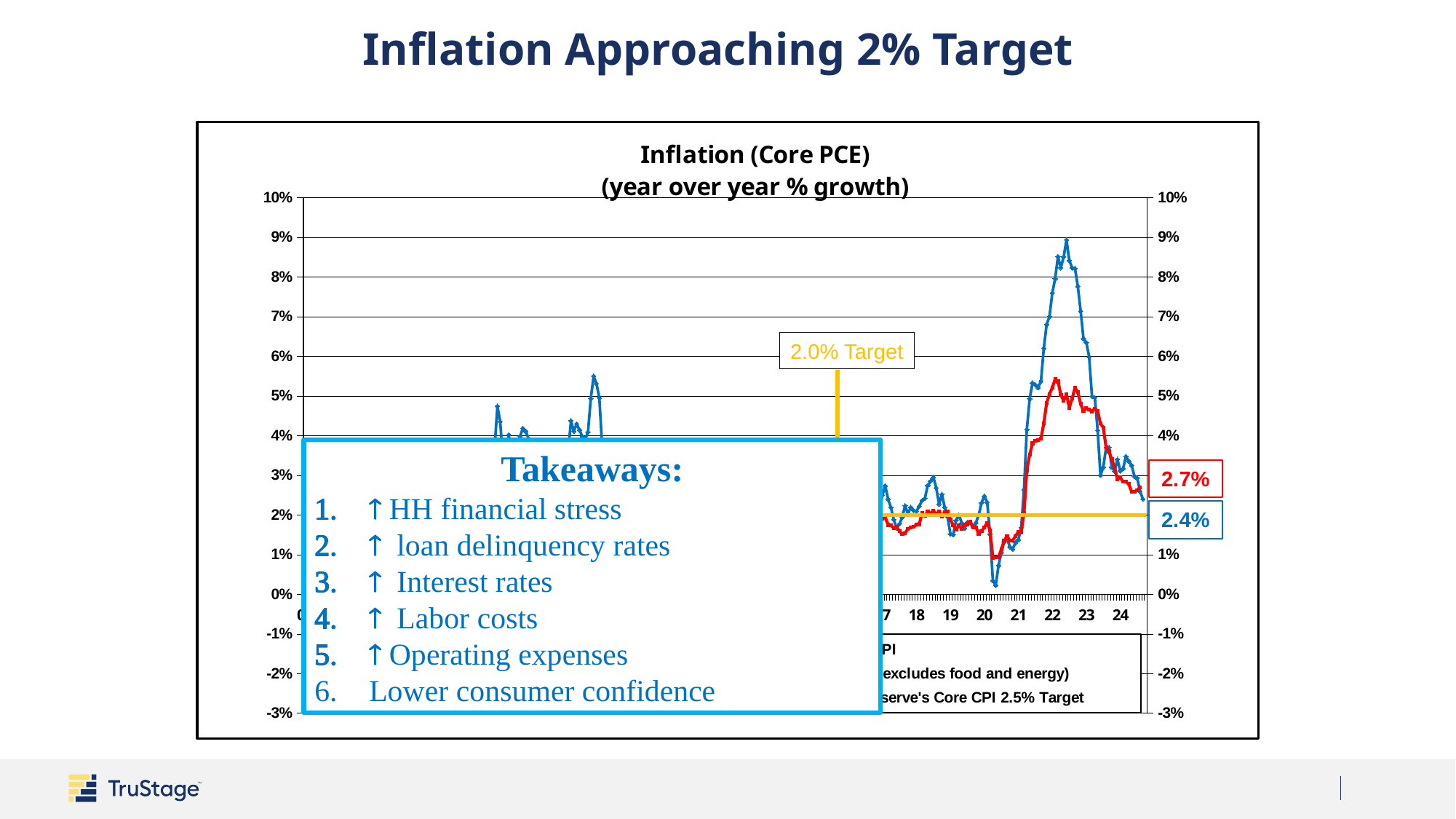
Is the lowest point of the blue line around 2020 greater or less than 1%? less Do the values of the blue line rise or fall from their 2022 peak to 2024? fall What is the latest value labelled for the blue line? 2.4% What is the latest value labelled for the red line? 2.7% What target level is marked by the yellow horizontal line? 2.0% Target What is the title of the chart? Inflation (Core PCE) (year over year % growth) Is the peak of the red line around 2022 greater or less than 5%? greater What kind of chart is shown on the slide? line chart Which line has the higher latest labelled value, the red line or the blue line? red line Is the peak of the blue line around 2022 greater or less than 8%? greater Is the latest labelled value of the blue line (2.4%) greater or less than the 2.0% target? greater What is the difference between the latest labelled values of the red line (2.7%) and the blue line (2.4%)? 0.3%